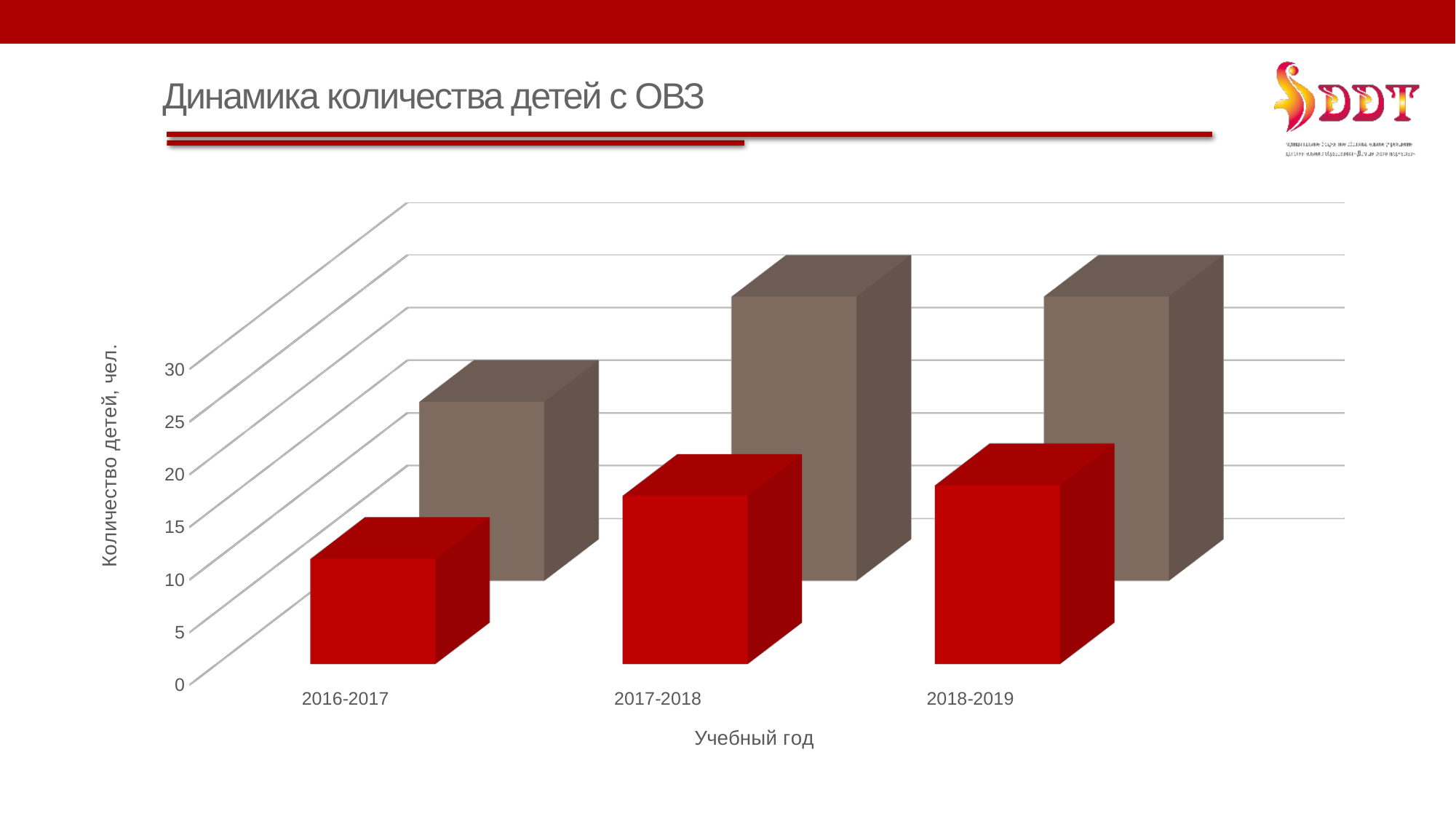
How many academic years (categories) are shown on the x axis? 3 Which academic year has the lowest red bar? 2016-2017 Is the value of the brown bar for 2016-2017 greater or less than 20? less For 2017-2018, which bar is larger, the red one or the brown one? the brown one Is the value of the brown bar for 2017-2018 greater or less than 20? greater Is the value of the red bar for 2016-2017 greater or less than 15? less How many series of bars are plotted in the chart? 2 What kind of chart is shown on the slide? bar chart Do the red bars rise or fall from 2016-2017 to 2018-2019? rise What is the title of the chart? Динамика количества детей с ОВЗ What is the label of the vertical axis? Количество детей, чел.